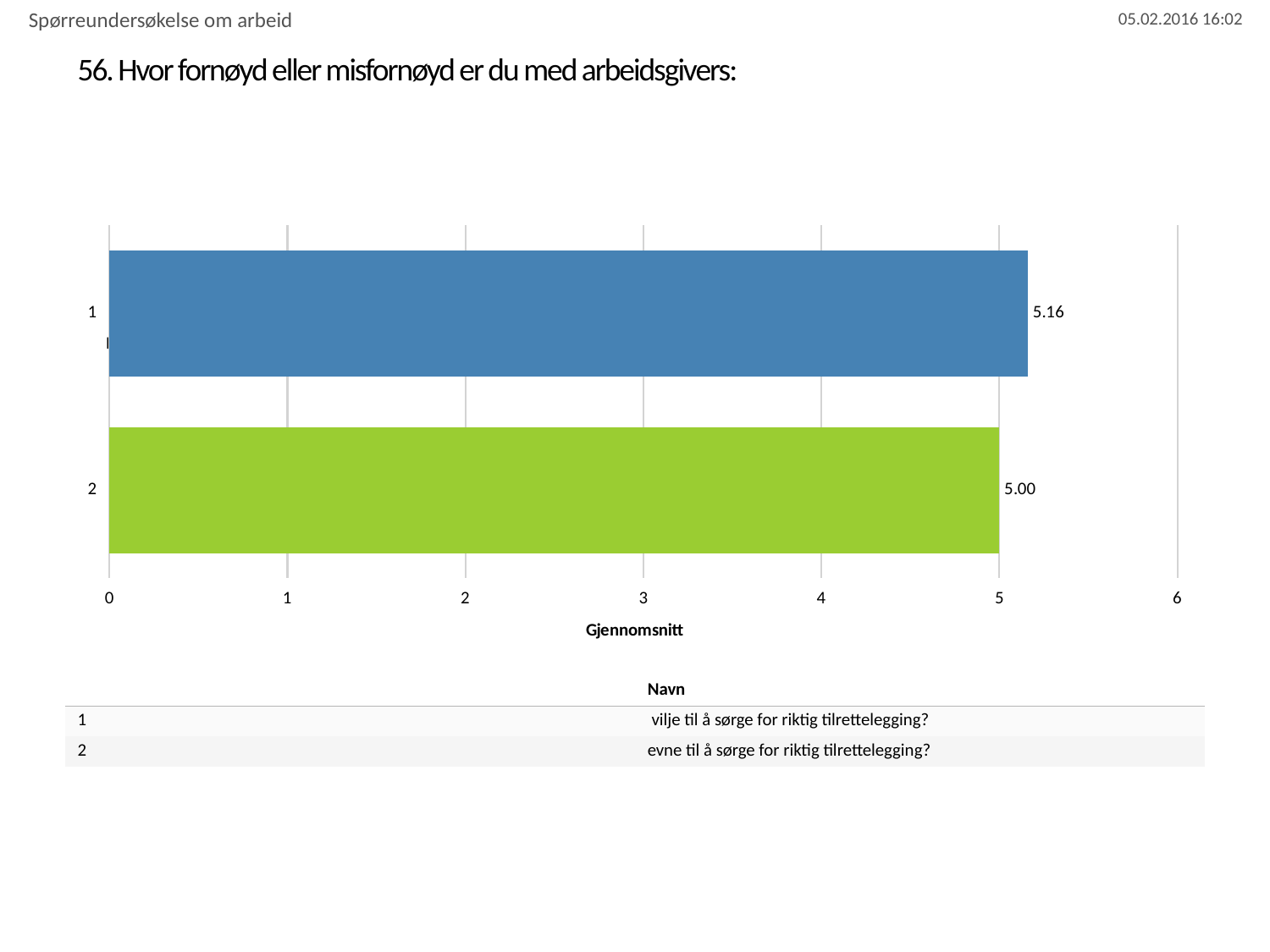
What is the value for category 1 (vilje til å sørge for riktig tilrettelegging?)? 5.16 What colour is the bar for category 2? Green How many categories are shown in the chart? 2 What is the label of the horizontal axis? Gjennomsnitt What kind of chart is shown on the slide? Bar chart What is the difference between the values for category 1 and category 2? 0.16 What is the value for category 2 (evne til å sørge for riktig tilrettelegging?)? 5.00 Is the value for category 1 greater or less than 5? greater Which is larger, the value for category 1 or category 2? Category 1 Which category has the highest value? 1 Which category has the lowest value? 2